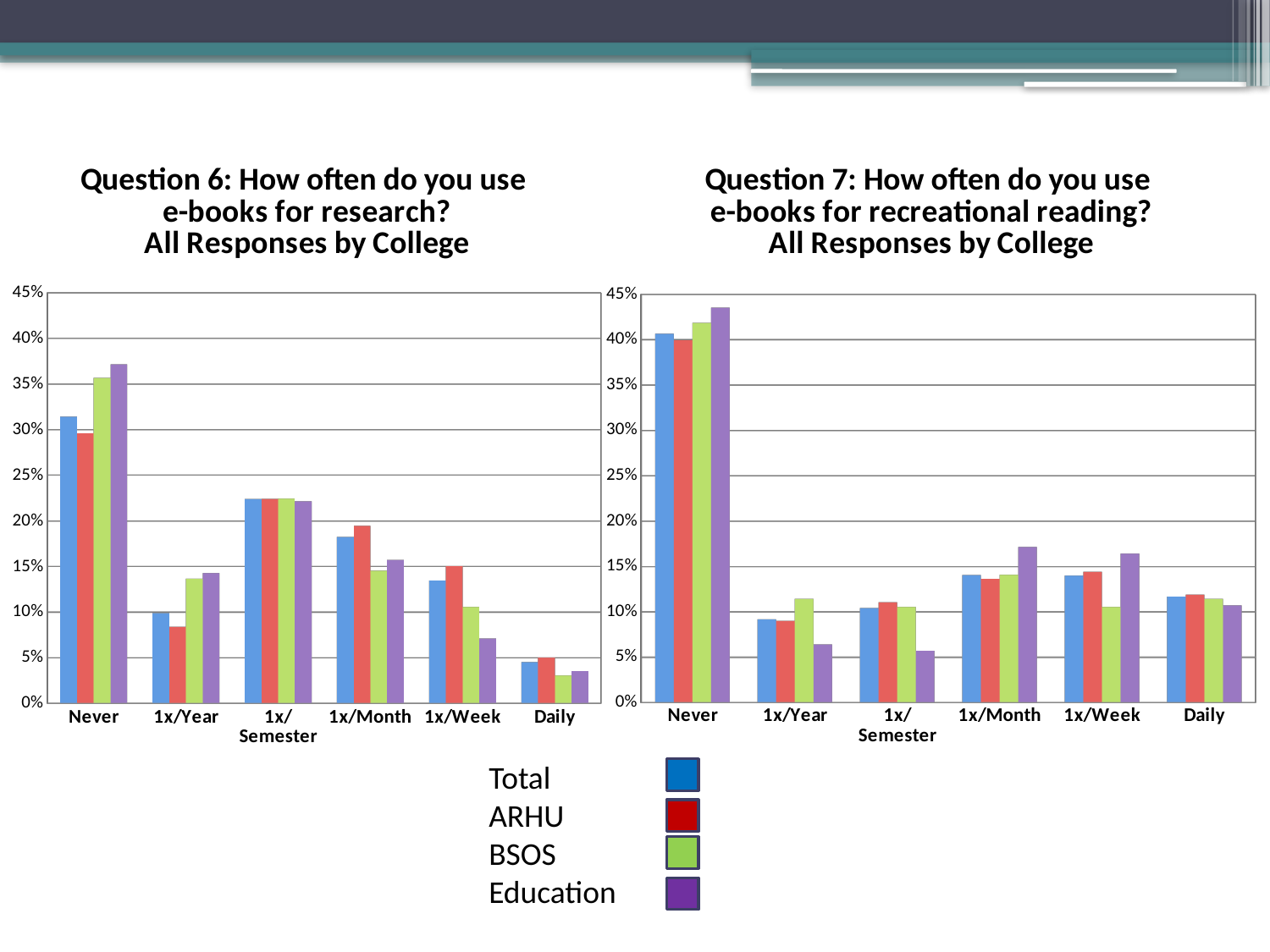
In the Question 7 chart, is the value for Education in the 1x/Month category greater or less than 15%? greater In the Question 7 chart, which series has the lowest bar in the 1x/Year category? Education In the Question 6 chart, is the value for Education in the Never category greater or less than 35%? greater In the Question 6 chart, which category has the lowest value for the Total series? Daily Which series is shown in purple in the legend? Education How many categories are shown on the x axis of the Question 7 chart? 6 In the Question 7 chart, which category has the highest value for the Total series? Never What kind of chart is the Question 6 chart on the left? bar chart In the Question 6 chart, which series has the highest bar in the Never category? Education In the Question 6 chart, which is larger in the 1x/Year category: BSOS or ARHU? BSOS In the Question 6 chart, do the Total values rise or fall from 1x/Semester to Daily? fall How many series does the legend list for the charts? 4